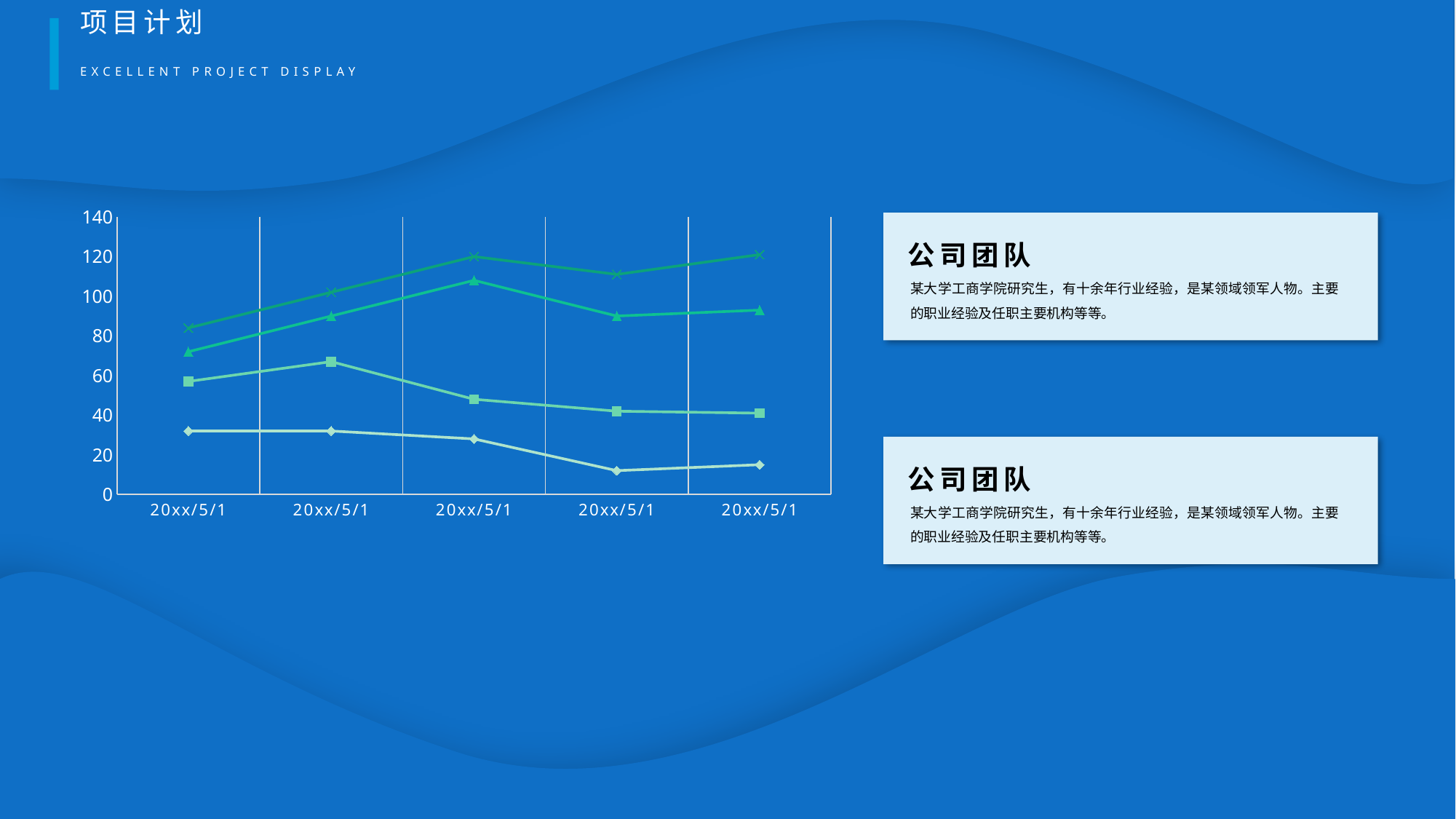
What kind of chart is shown on the slide? line chart How many lines are plotted in the chart? 4 Is the value of the line with square markers at the first point greater or less than 40? greater Is the value of the line with triangle markers at the first point greater or less than 80? less Is the value of the line with diamond markers at the fourth point greater or less than 20? less How many data points does each line in the chart have? 5 Which line has the lowest value at the third point? the line with diamond markers At the first point, which is higher: the line with x markers or the line with diamond markers? the line with x markers Does the line with diamond markers rise or fall overall from the first point to the last point? fall What is the highest value shown on the chart's vertical axis? 140 Which line has the highest value at the last point? the line with x markers